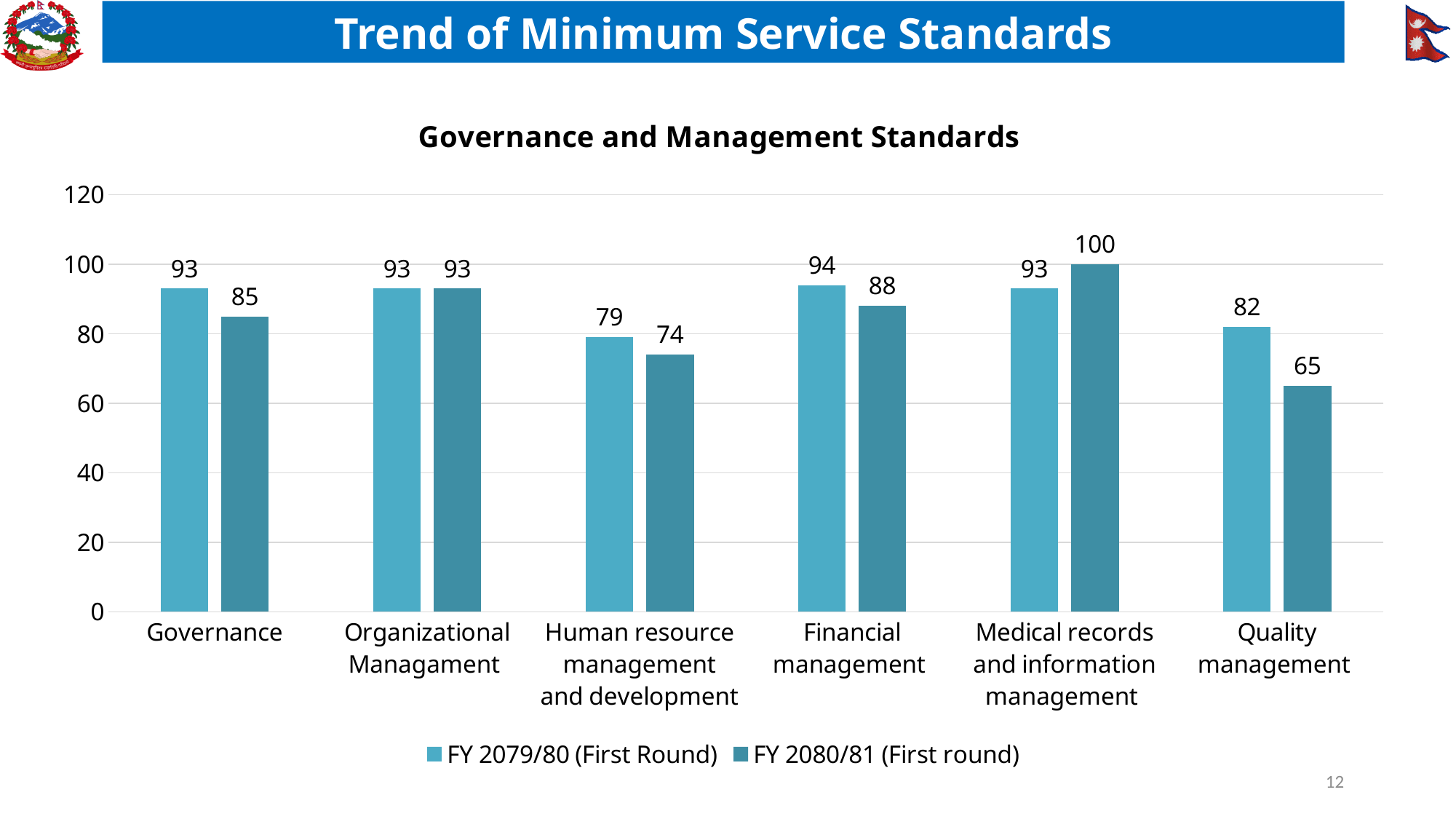
What is the value for Human resource management and development in FY 2080/81 (First round)? 74 Which category has the highest value in FY 2080/81 (First round)? Medical records and information management What is the value for Quality management in FY 2080/81 (First round)? 65 Which category has the lowest value in FY 2079/80 (First Round)? Human resource management and development How many series does the legend list? 2 What is the difference between the FY 2079/80 (First Round) and FY 2080/81 (First round) values for Quality management? 17 How many categories are shown on the x axis? 6 Which is larger for Financial management: the FY 2079/80 (First Round) value or the FY 2080/81 (First round) value? FY 2079/80 (First Round) What kind of chart is shown on the slide? Bar chart What is the value for Governance in FY 2079/80 (First Round)? 93 Is the value for Medical records and information management in FY 2080/81 (First round) greater or less than 80? greater What is the title of the chart? Governance and Management Standards